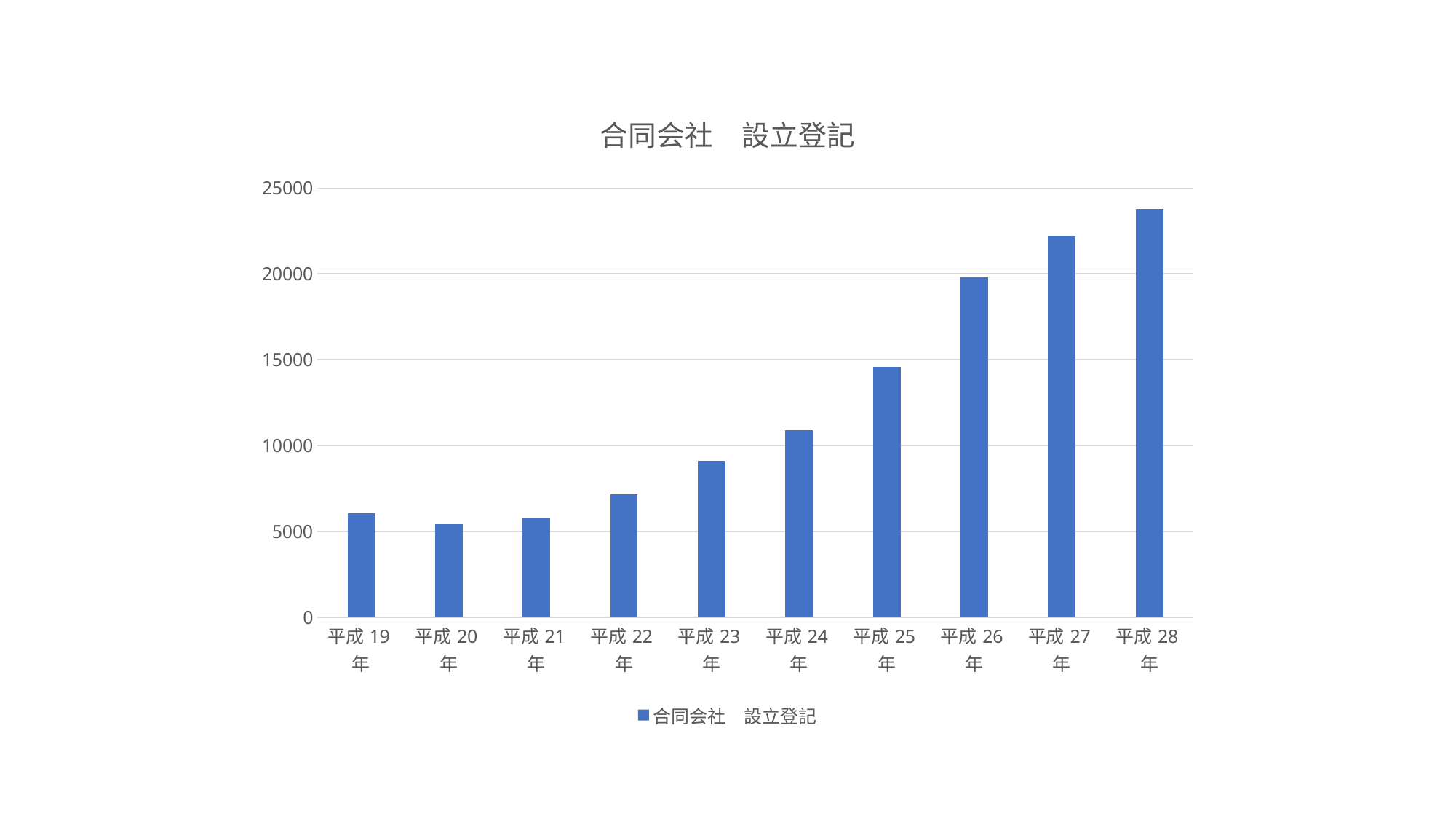
How many years (categories) are plotted on the x axis? 10 Which is larger, the value for 平成23年 or the value for 平成22年? 平成23年 Do the values generally rise or fall from 平成21年 to 平成28年? rise Is the value for 平成23年 greater or less than 10000? less Is the value for 平成19年 greater or less than 5000? greater Which year has the highest value? 平成28年 What is the title of the chart? 合同会社 設立登記 Is the value for 平成28年 greater or less than 20000? greater Which year has the lowest value? 平成20年 What kind of chart is shown on the slide? bar chart How many series does the legend list? 1